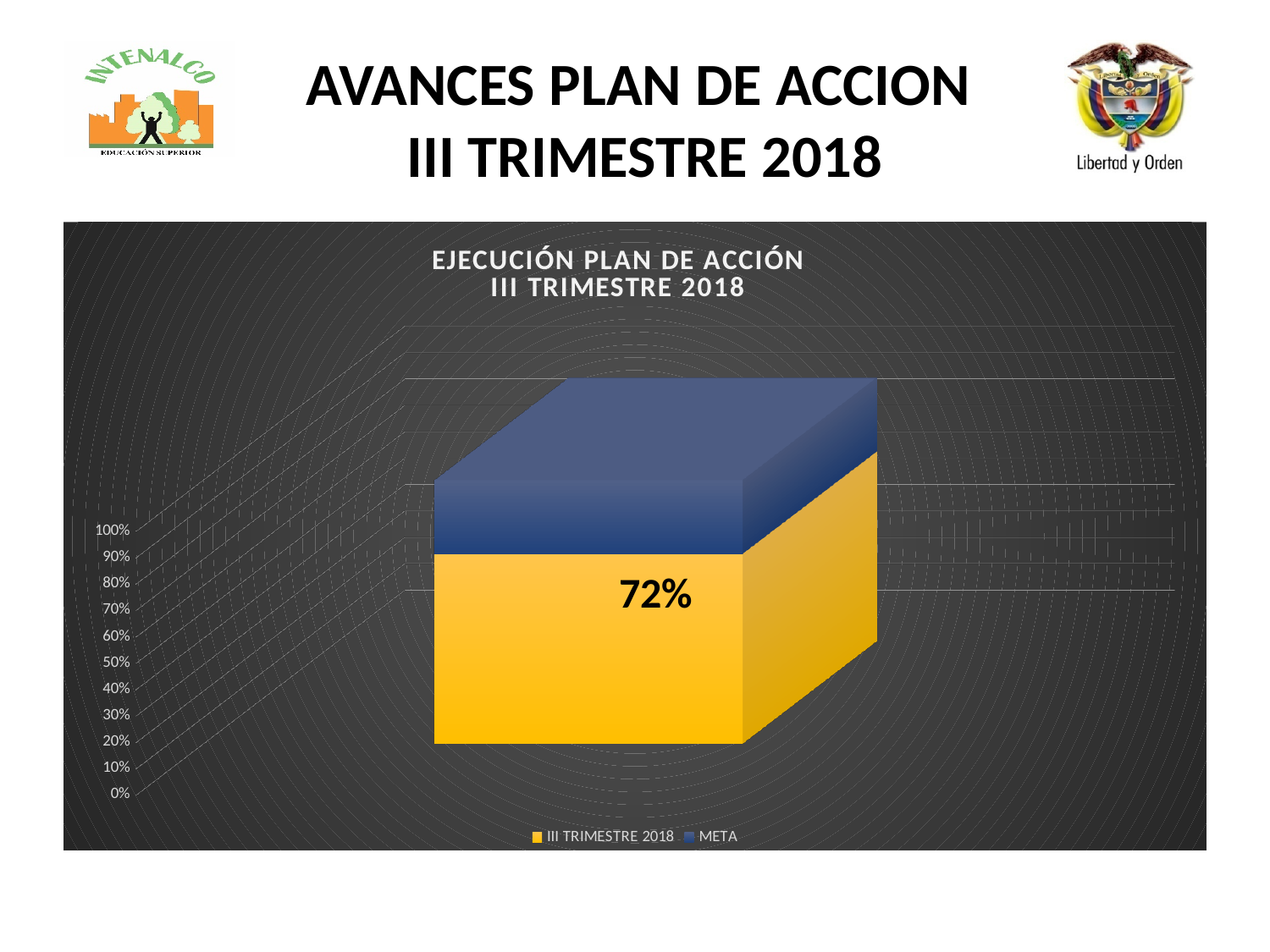
Which series is shown in yellow in the legend? III TRIMESTRE 2018 What kind of chart is shown on the slide? Bar chart Is the value for III TRIMESTRE 2018 greater or less than 50%? greater What is the value shown for III TRIMESTRE 2018? 72% What is the highest value shown on the vertical axis? 100% How many series does the legend list? 2 What is the title of the chart? EJECUCIÓN PLAN DE ACCIÓN III TRIMESTRE 2018